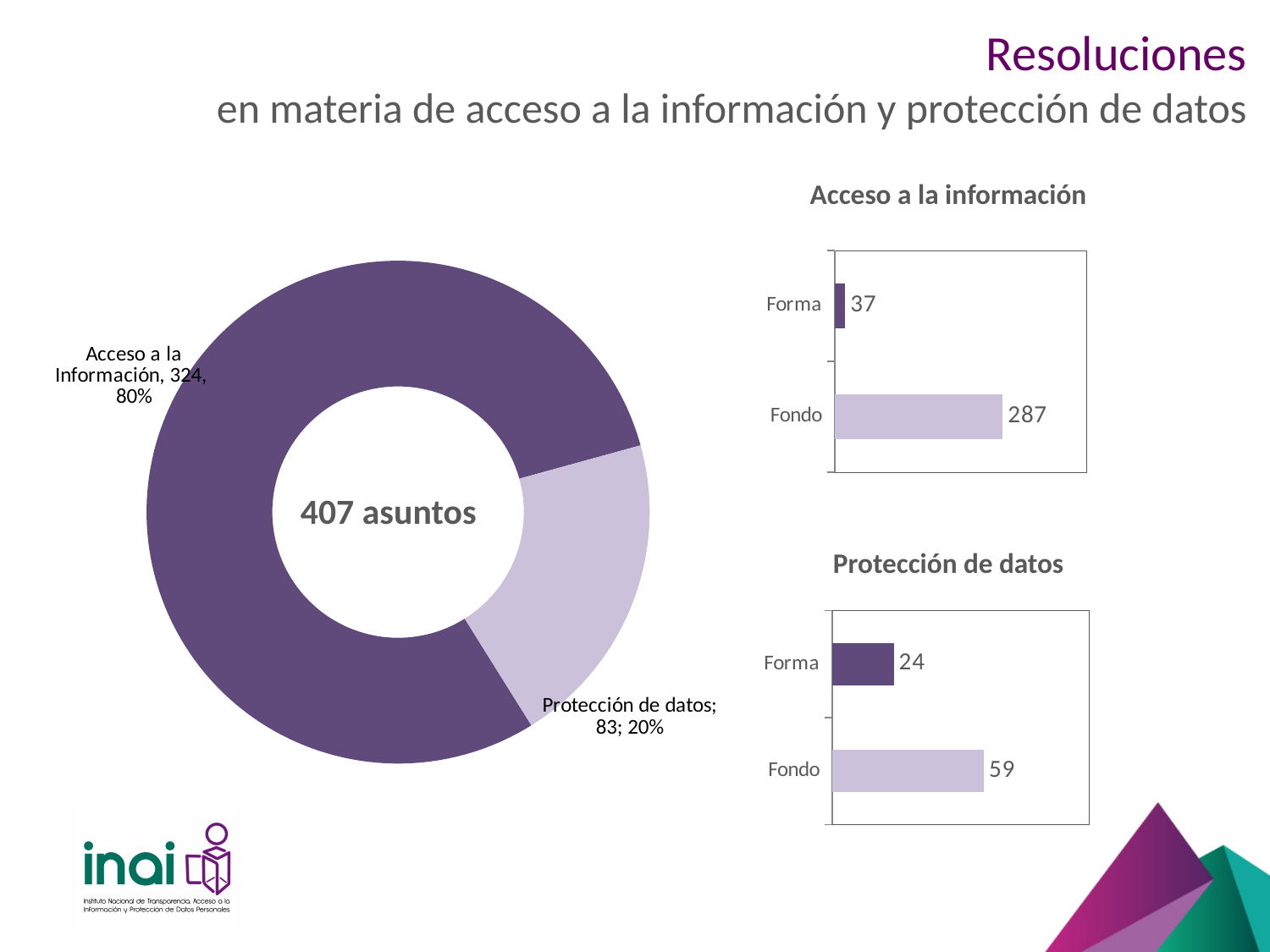
In the 'Acceso a la información' chart, what is the value for Fondo? 287 In the 'Protección de datos' chart, what is the total of Forma and Fondo? 83 In the 'Acceso a la información' chart, which category has the highest value? Fondo In the donut chart on the left, what is the difference between Acceso a la Información and Protección de datos? 241 In the 'Protección de datos' chart, what is the value for Forma? 24 In the 'Acceso a la información' chart, what is the difference between Fondo and Forma? 250 In the 'Protección de datos' chart, which category has the lowest value? Forma What kind of chart is the 'Protección de datos' chart? Bar chart In the donut chart on the left, what share of the total does Protección de datos represent? 20% In the 'Acceso a la información' chart, what is the value for Forma? 37 In the donut chart on the left, what total is shown in the centre? 407 asuntos In the donut chart on the left, what is the value for Acceso a la Información? 324